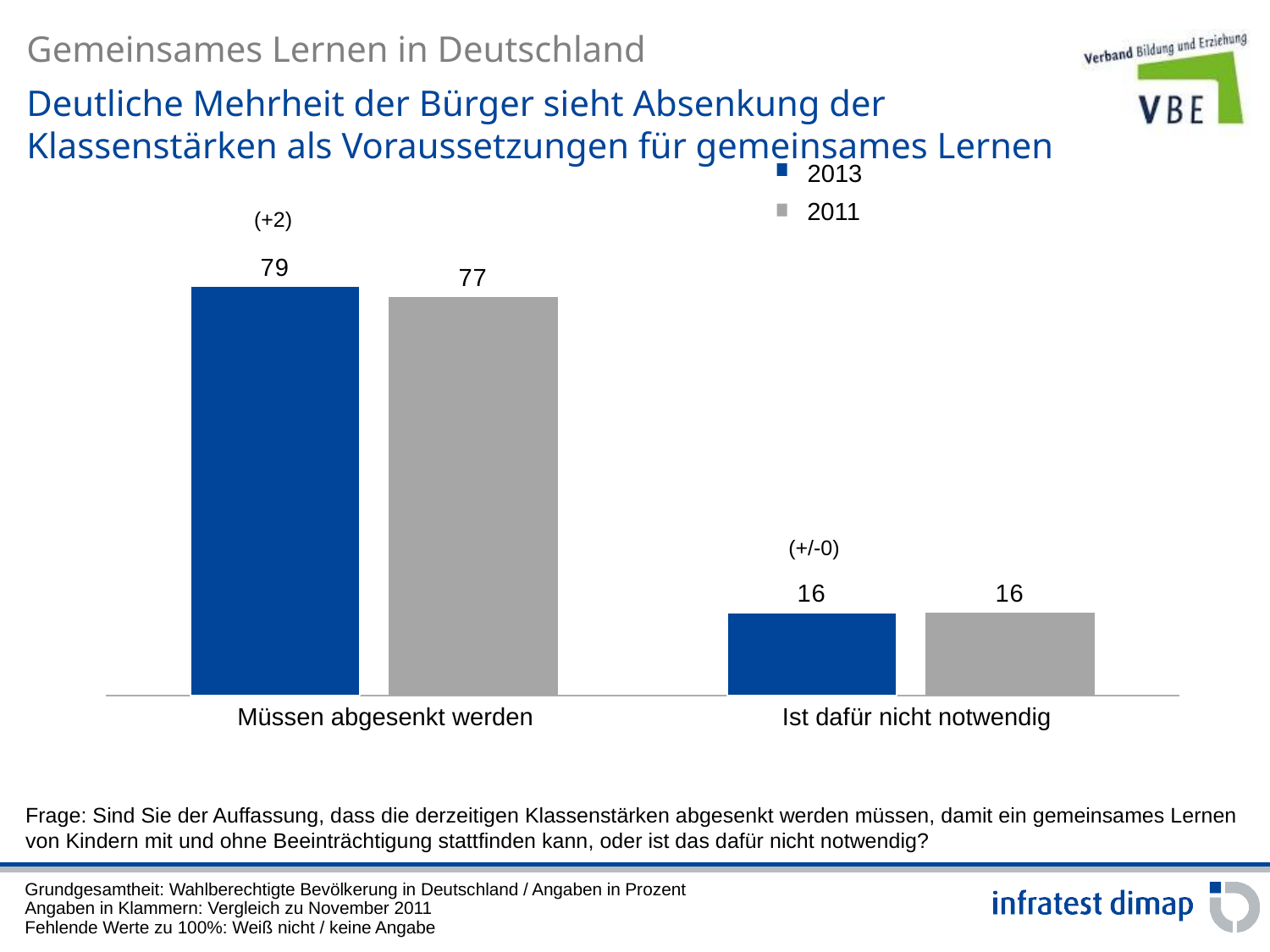
Which is larger: the 2013 value for "Müssen abgesenkt werden" or the 2011 value for "Müssen abgesenkt werden"? 2013 value for Müssen abgesenkt werden What is the 2013 value for "Müssen abgesenkt werden"? 79 What is the 2013 value for "Ist dafür nicht notwendig"? 16 What is the 2011 value for "Ist dafür nicht notwendig"? 16 How many categories are shown on the x axis? 2 Which category has the highest 2013 value? Müssen abgesenkt werden What is the 2011 value for "Müssen abgesenkt werden"? 77 What is the difference between the 2013 values for "Müssen abgesenkt werden" and "Ist dafür nicht notwendig"? 63 How many series does the legend list? 2 Which category has the lowest 2011 value? Ist dafür nicht notwendig What is the difference between the 2013 and 2011 values for "Müssen abgesenkt werden"? 2 What kind of chart is shown on the slide? Bar chart